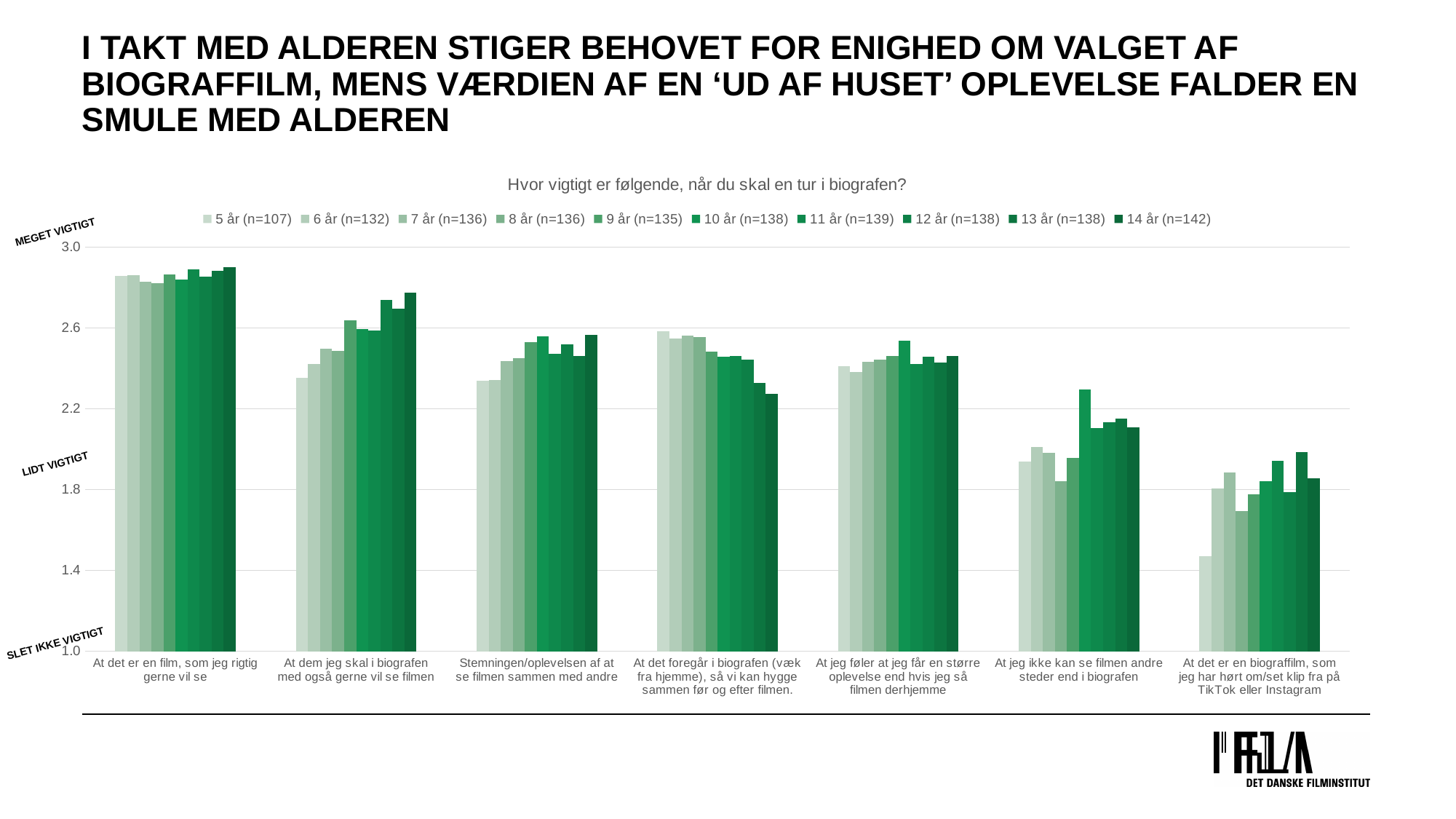
Which category has the highest values across all age groups? At det er en film, som jeg rigtig gerne vil se How many series does the chart's legend list? 10 How many categories are shown along the x axis of the chart? 7 Is the value for 11 år (n=139) in the category 'At jeg ikke kan se filmen andre steder end i biografen' greater or less than 2.2? less Is the value for 14 år (n=142) in the category 'At det er en film, som jeg rigtig gerne vil se' greater or less than 2.6? greater What kind of chart is shown on the slide? Bar chart In the category 'At jeg ikke kan se filmen andre steder end i biografen', which age group has the highest value? 10 år (n=138) What is the title of the chart? Hvor vigtigt er følgende, når du skal en tur i biografen? In the category 'At dem jeg skal i biografen med også gerne vil se filmen', do the values generally rise or fall as age increases? rise Which category has the lowest values across all age groups? At det er en biograffilm, som jeg har hørt om/set klip fra på TikTok eller Instagram In the category 'At det foregår i biografen (væk fra hjemme), så vi kan hygge sammen før og efter filmen.', which is larger: the value for 5 år (n=107) or for 14 år (n=142)? 5 år (n=107) Is the value for 5 år (n=107) in the category 'At det er en biograffilm, som jeg har hørt om/set klip fra på TikTok eller Instagram' greater or less than 1.8? less